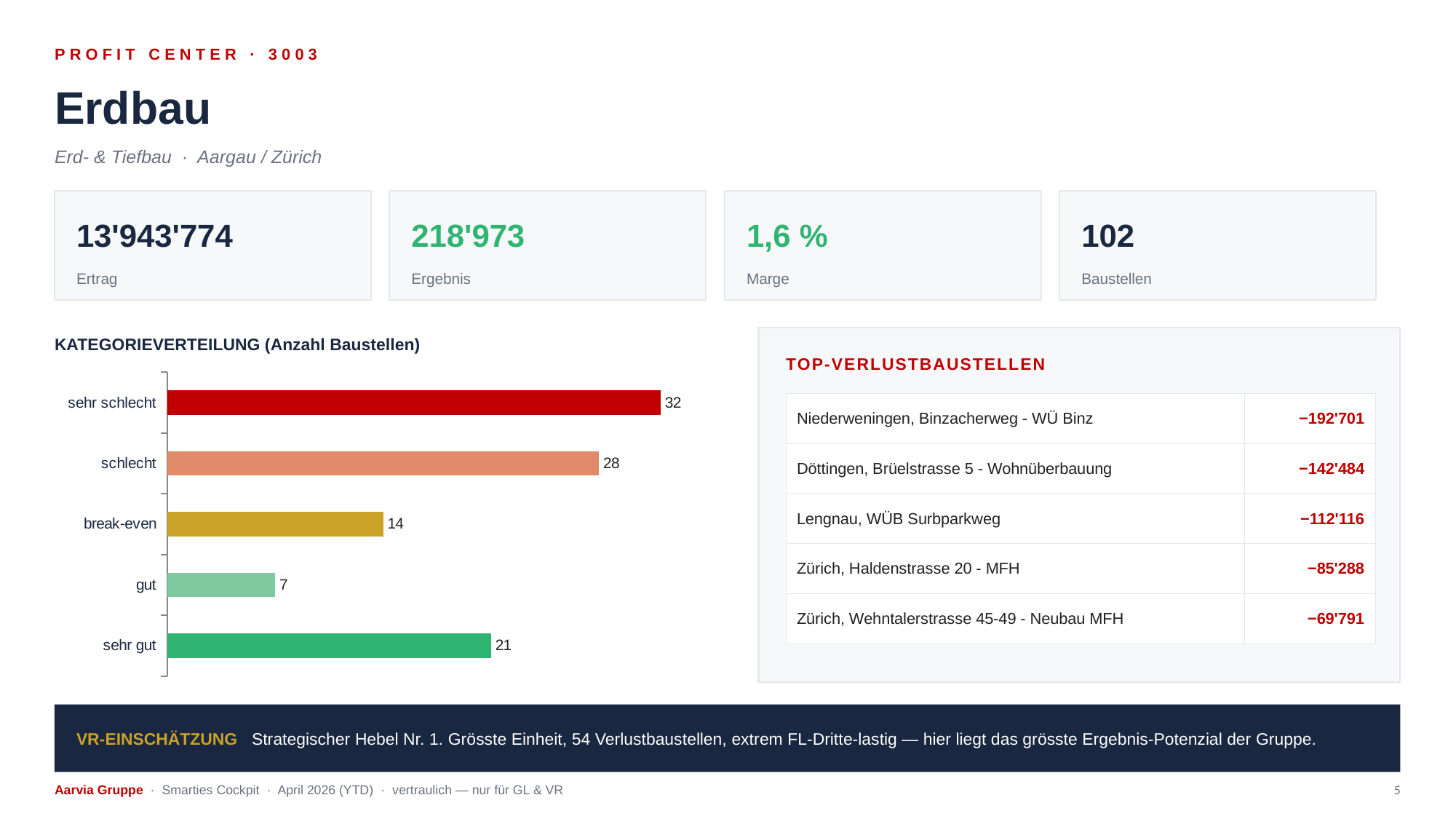
What colour is the 'sehr schlecht' bar in the KATEGORIEVERTEILUNG chart? red In the KATEGORIEVERTEILUNG chart, which category has the highest number of Baustellen? sehr schlecht In the KATEGORIEVERTEILUNG chart, which is larger: 'sehr gut' or 'break-even'? sehr gut In the KATEGORIEVERTEILUNG chart, what is the difference between 'sehr gut' and 'gut'? 14 In the KATEGORIEVERTEILUNG chart, what is the difference between 'sehr schlecht' and 'schlecht'? 4 What is the total number of Baustellen across all five categories in the KATEGORIEVERTEILUNG chart? 102 How many categories are shown in the KATEGORIEVERTEILUNG chart? 5 In the KATEGORIEVERTEILUNG chart, what is the value for 'sehr schlecht'? 32 In the KATEGORIEVERTEILUNG chart, which category has the lowest number of Baustellen? gut In the KATEGORIEVERTEILUNG chart, what is the value for 'break-even'? 14 In the KATEGORIEVERTEILUNG chart, what is the value for 'gut'? 7 What kind of chart is the KATEGORIEVERTEILUNG chart? bar chart